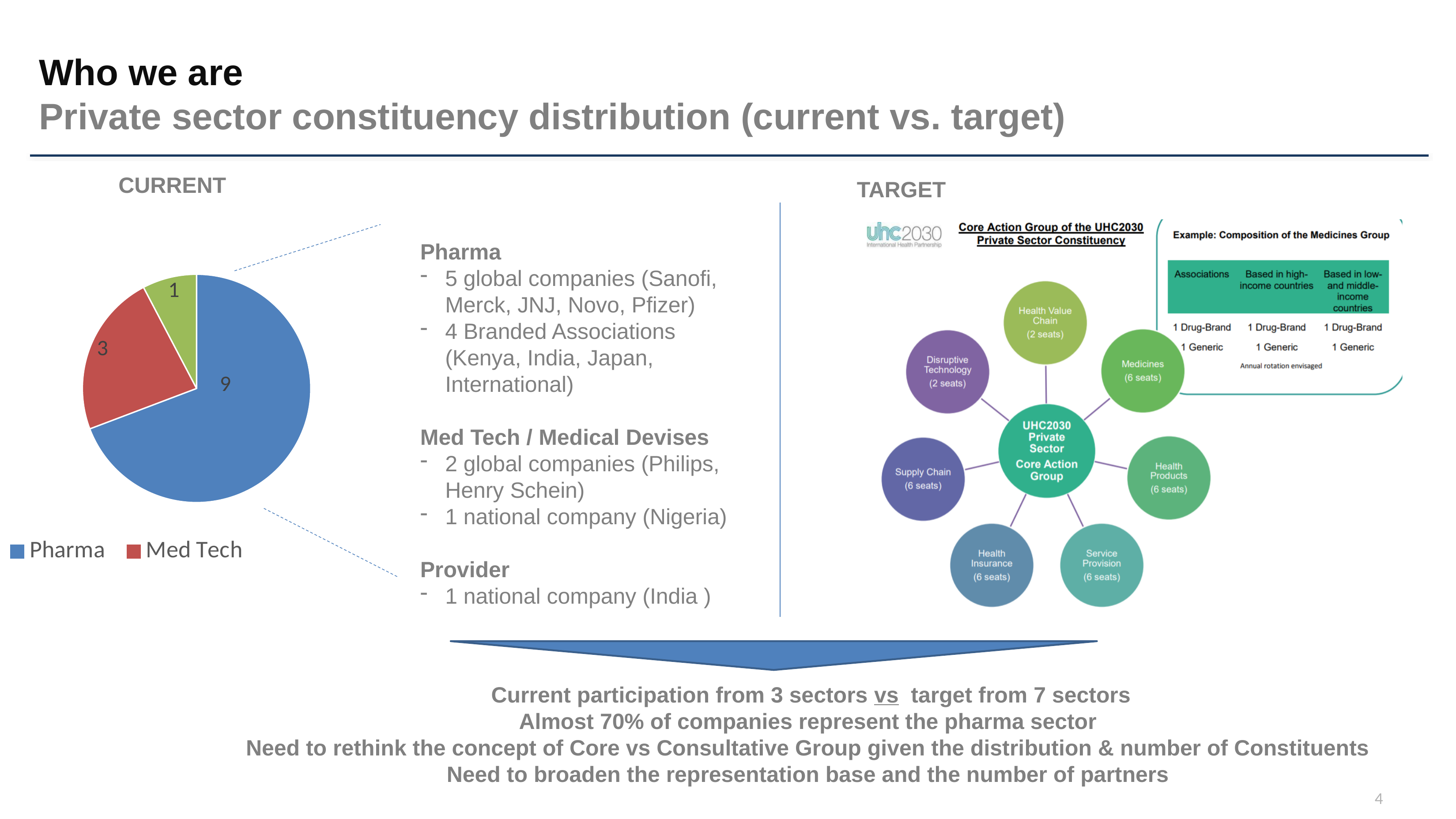
What heading appears above the pie chart on the left of the slide? CURRENT In the CURRENT pie chart, what is the difference between the Pharma value and the Med Tech value? 6 In the CURRENT pie chart, what is the sum of all the slice values shown? 13 How many entries does the legend of the CURRENT pie chart list? 2 What kind of chart is shown under the heading CURRENT? pie chart What colour is the Pharma slice in the CURRENT pie chart? blue How many slices does the CURRENT pie chart have? 3 In the CURRENT pie chart, what is the value for Pharma? 9 In the CURRENT pie chart, which category has the largest slice? Pharma In the CURRENT pie chart, which is larger, Pharma or Med Tech? Pharma In the CURRENT pie chart, what is the value for Med Tech? 3